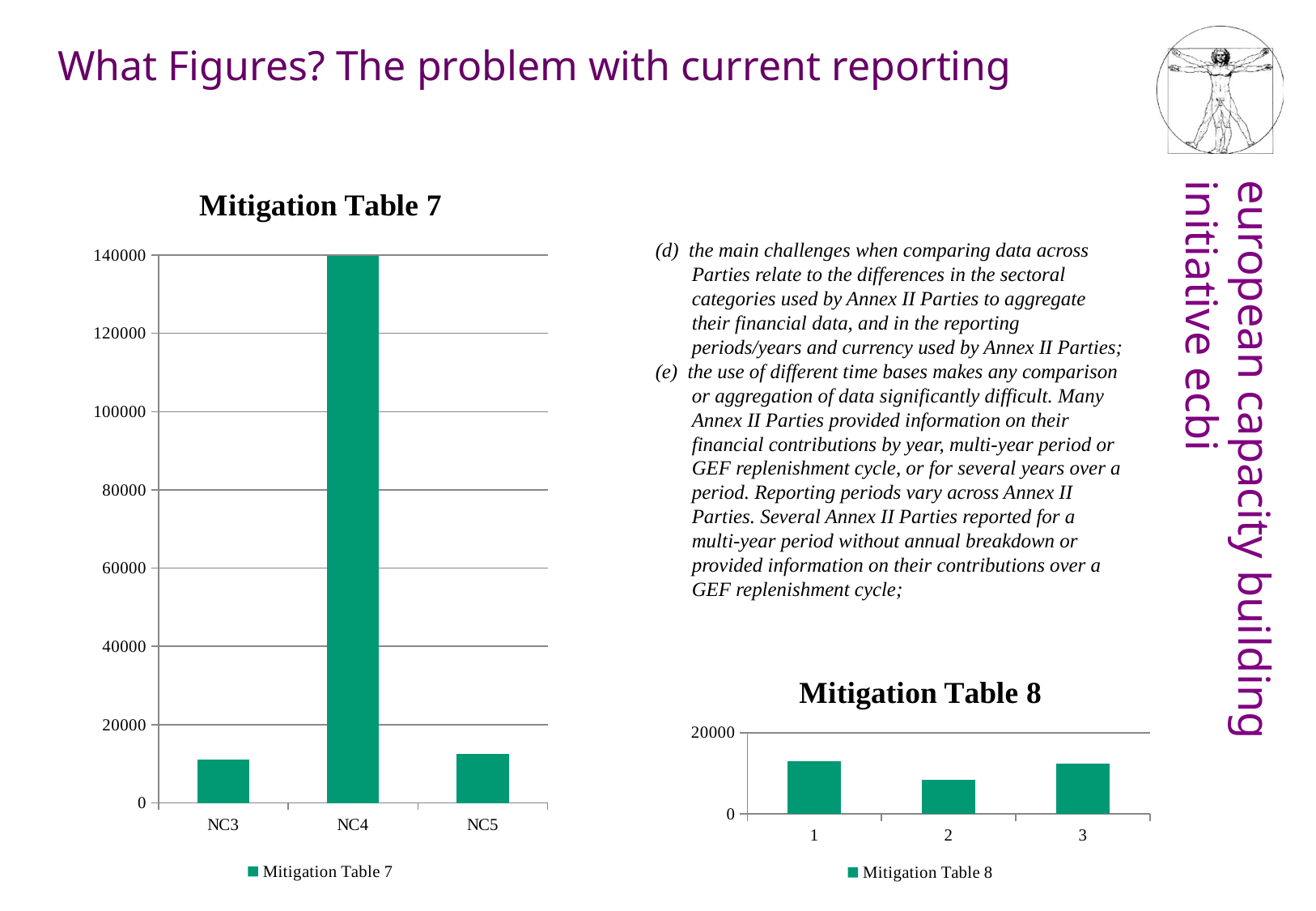
In the Mitigation Table 7 chart, is the value for NC4 greater or less than 120000? greater What kind of chart is the Mitigation Table 8 chart? bar chart In the Mitigation Table 8 chart, which category has the lowest value? 2 In the Mitigation Table 7 chart, which category has the highest value? NC4 How many series does the legend of the Mitigation Table 7 chart list? 1 How many bars are shown in the Mitigation Table 8 chart? 3 In the Mitigation Table 7 chart, which is larger, the value for NC4 or the value for NC5? NC4 What is the legend entry shown below the Mitigation Table 8 chart? Mitigation Table 8 In the Mitigation Table 7 chart, is the value for NC3 greater or less than 20000? less What kind of chart is the Mitigation Table 7 chart? bar chart How many categories are shown on the x axis of the Mitigation Table 7 chart? 3 In the Mitigation Table 8 chart, is the value for category 1 greater or less than 20000? less